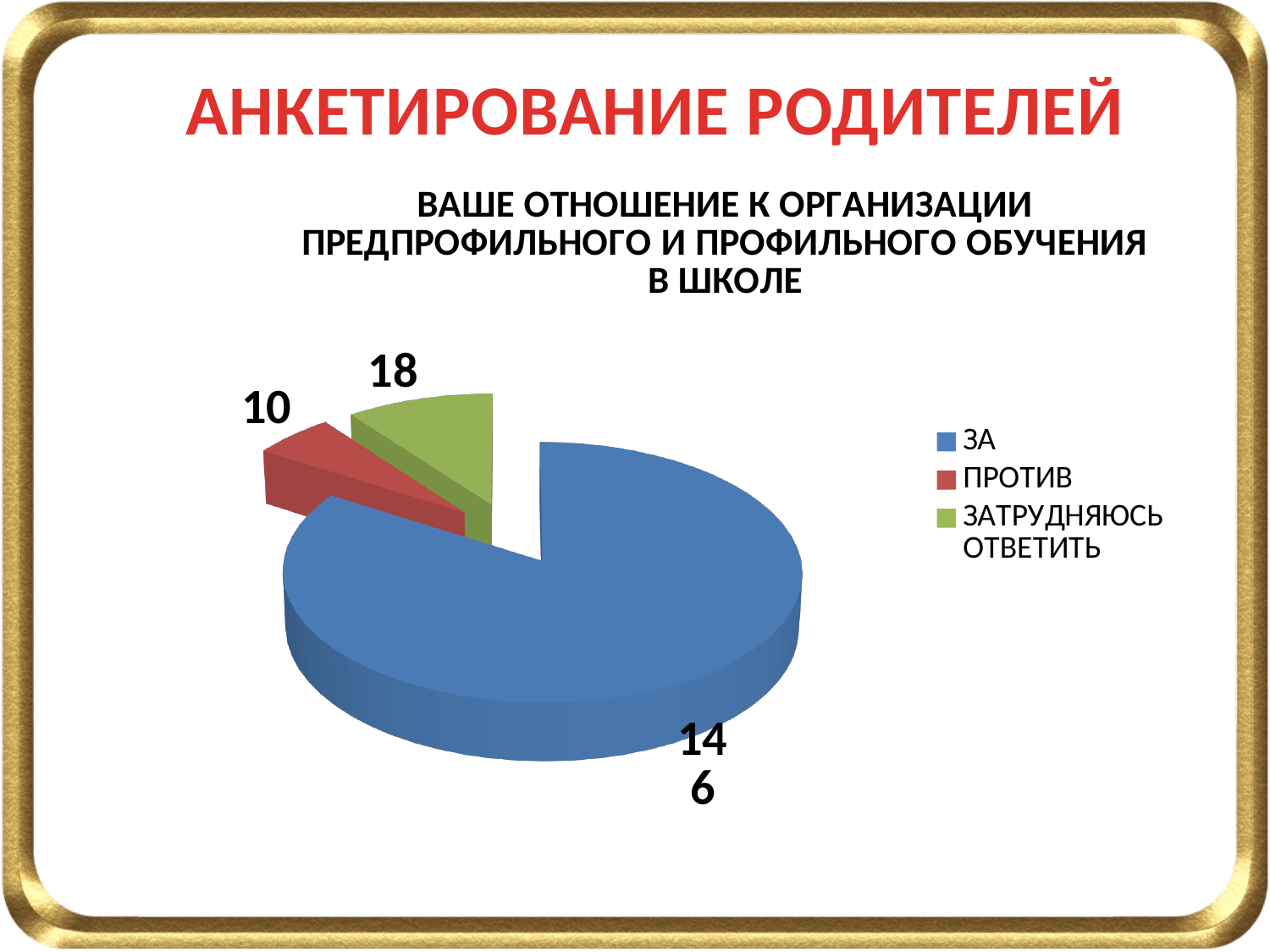
What type of chart is shown on the slide? pie chart Which is larger, the value for ПРОТИВ or the value for ЗАТРУДНЯЮСЬ ОТВЕТИТЬ? ЗАТРУДНЯЮСЬ ОТВЕТИТЬ What colour is the slice for ЗА? blue How many categories does the pie chart have? 3 What is the difference between the values for ЗАТРУДНЯЮСЬ ОТВЕТИТЬ and ПРОТИВ? 8 What colour is the slice for ПРОТИВ? red Which category has the largest slice of the pie? ЗА Which category has the smallest slice of the pie? ПРОТИВ What is the value for ЗАТРУДНЯЮСЬ ОТВЕТИТЬ? 18 How many entries does the legend list? 3 What is the value for ПРОТИВ? 10